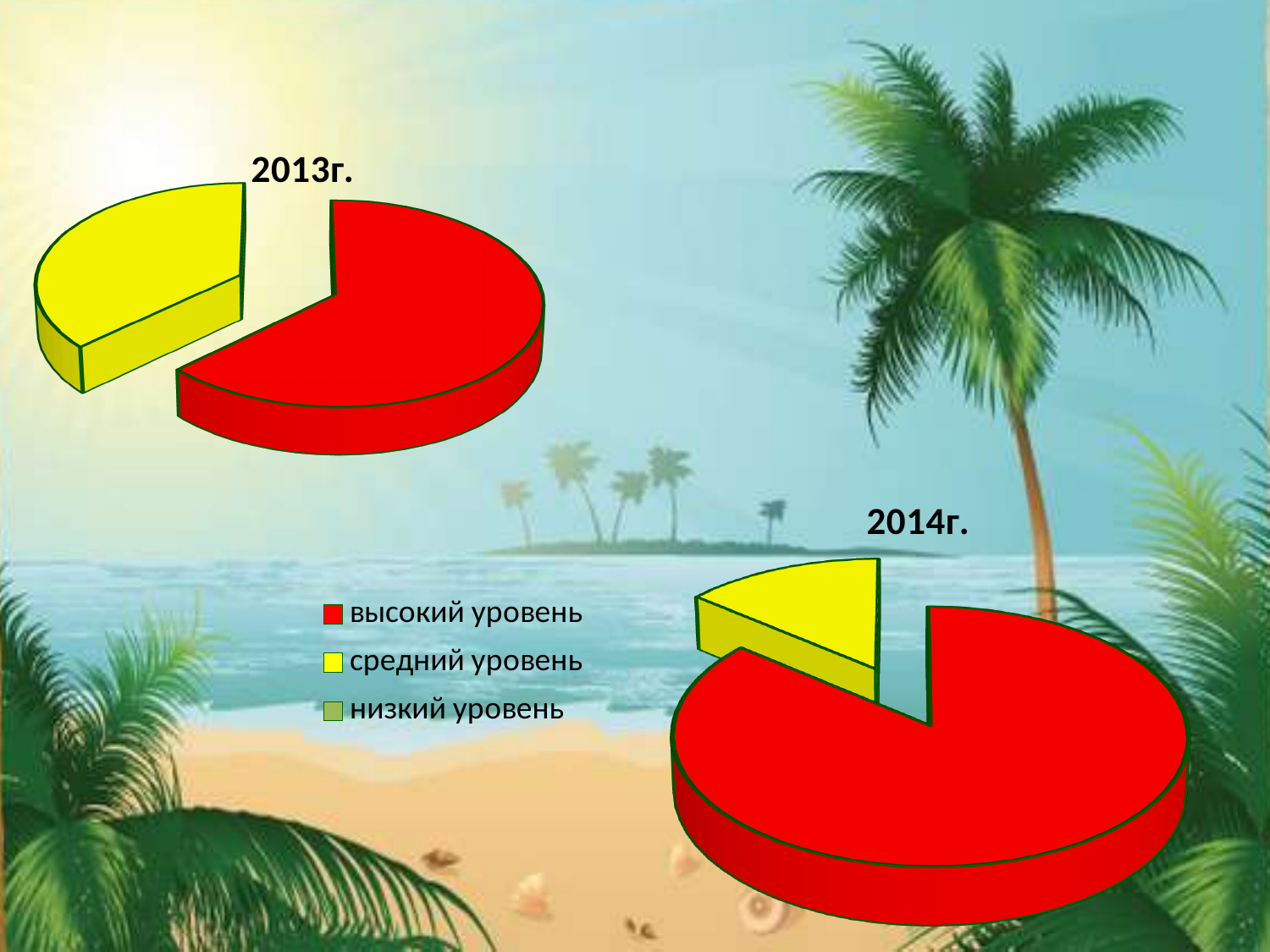
Which colour represents высокий уровень in the legend? red What kind of chart is the chart titled "2014г."? pie chart How many entries does the legend list for the pie charts? 3 Is the share of высокий уровень larger in the chart titled "2013г." or in the chart titled "2014г."? 2014г. In the chart titled "2013г.", which slice is larger: высокий уровень or средний уровень? высокий уровень What kind of chart is the chart titled "2013г."? pie chart In the chart titled "2014г.", which slice is larger: высокий уровень or средний уровень? высокий уровень In the chart titled "2013г.", which category has the largest slice? высокий уровень Which colour represents средний уровень in the legend? yellow In the chart titled "2014г.", which category has the largest slice? высокий уровень